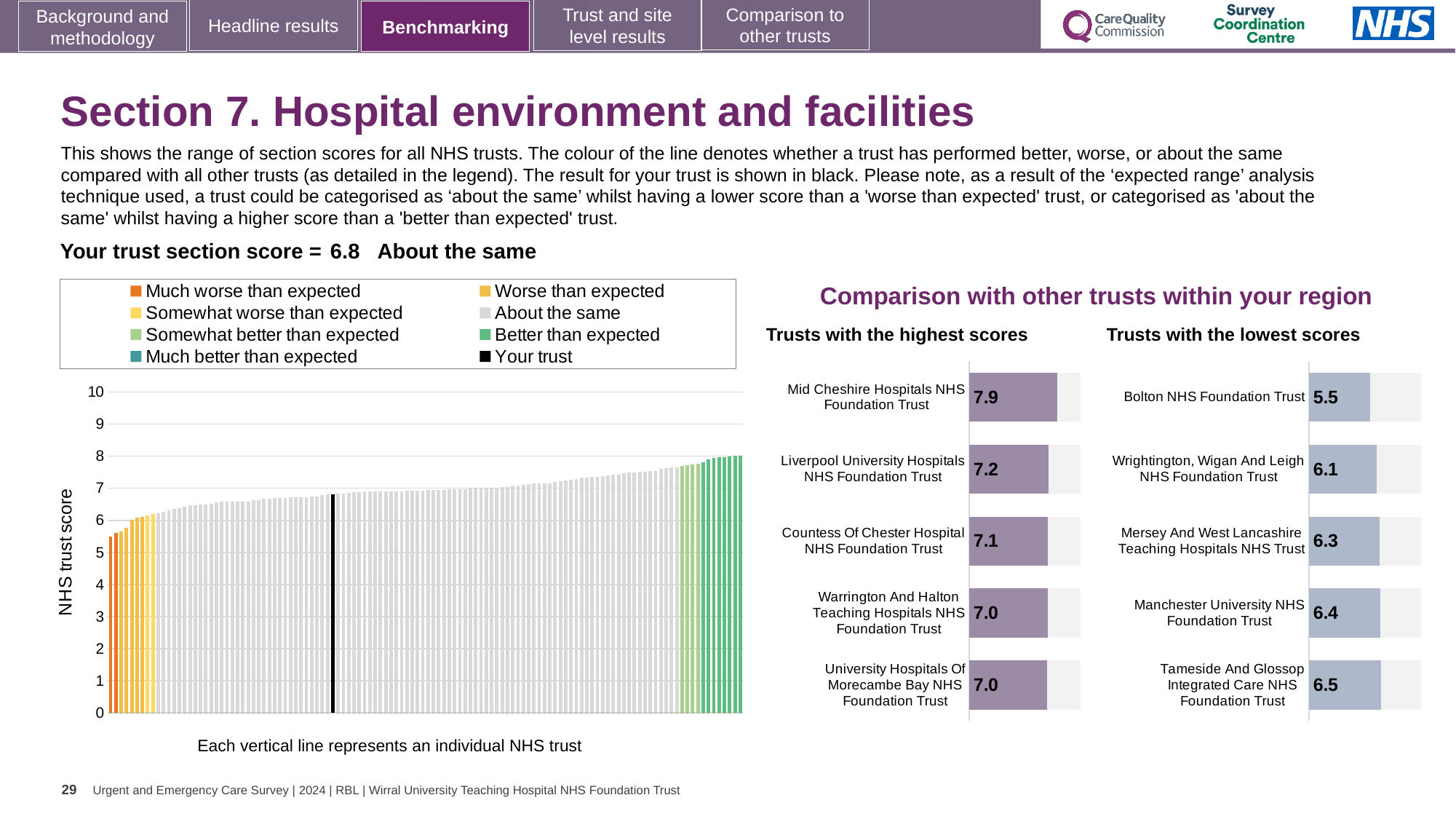
In the 'Trusts with the highest scores' chart, which trust has the highest score? Mid Cheshire Hospitals NHS Foundation Trust In the 'Trusts with the lowest scores' chart, which trust has the lowest score? Bolton NHS Foundation Trust In the 'Trusts with the highest scores' chart, what is the score for Mid Cheshire Hospitals NHS Foundation Trust? 7.9 How many entries does the legend of the main chart of all NHS trusts list? 8 In the main chart of all NHS trusts, what is the section score for your trust (shown in black)? 6.8 In the 'Trusts with the lowest scores' chart, how much higher is the score of Tameside And Glossop Integrated Care NHS Foundation Trust than that of Bolton NHS Foundation Trust? 1.0 What kind of chart is the main chart of all NHS trusts on the left of the slide? Bar chart In the main chart of all NHS trusts, do the scores rise or fall from left to right? Rise How many trusts are listed in the 'Trusts with the lowest scores' chart? 5 In the 'Trusts with the highest scores' chart, which has the larger score: Countess Of Chester Hospital NHS Foundation Trust or Warrington And Halton Teaching Hospitals NHS Foundation Trust? Countess Of Chester Hospital NHS Foundation Trust In the 'Trusts with the highest scores' chart, what is the difference between the scores of Mid Cheshire Hospitals NHS Foundation Trust and Liverpool University Hospitals NHS Foundation Trust? 0.7 In the 'Trusts with the lowest scores' chart, what is the score for Bolton NHS Foundation Trust? 5.5